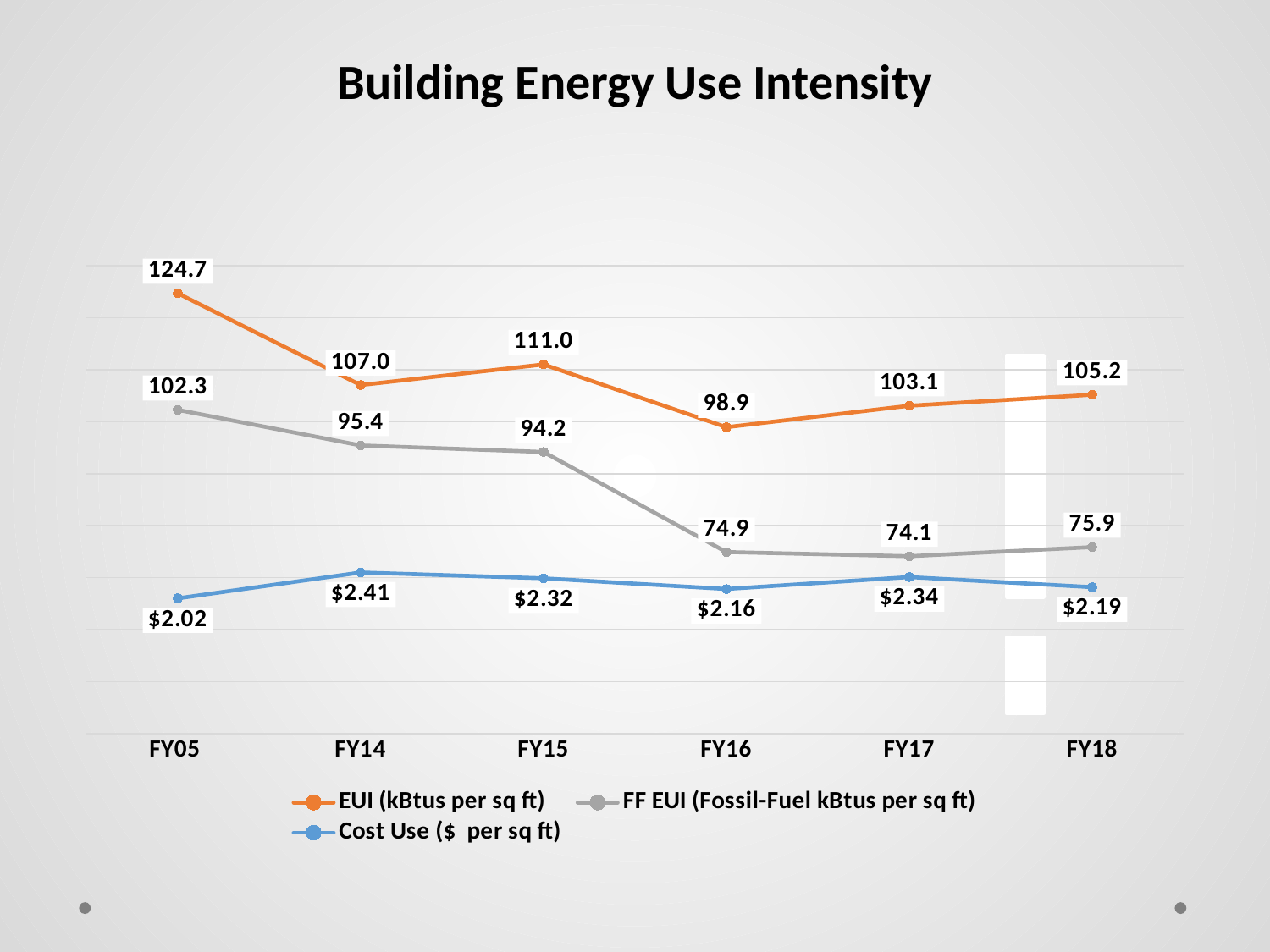
Which is larger, the Cost Use ($ per sq ft) value for FY17 or for FY18? FY17 What is the difference between the EUI (kBtus per sq ft) values for FY05 and FY14? 17.7 How many fiscal years are shown on the x axis? 6 What is the Cost Use ($ per sq ft) value for FY14? $2.41 What is the title of the chart? Building Energy Use Intensity How many series does the legend list? 3 What is the difference between the EUI and FF EUI values in FY18? 29.3 In which fiscal year is the EUI (kBtus per sq ft) series lowest? FY16 What kind of chart is shown on the slide? Line chart In which fiscal year is the FF EUI (Fossil-Fuel kBtus per sq ft) series highest? FY05 What is the FF EUI (Fossil-Fuel kBtus per sq ft) value for FY16? 74.9 What is the EUI (kBtus per sq ft) value for FY05? 124.7